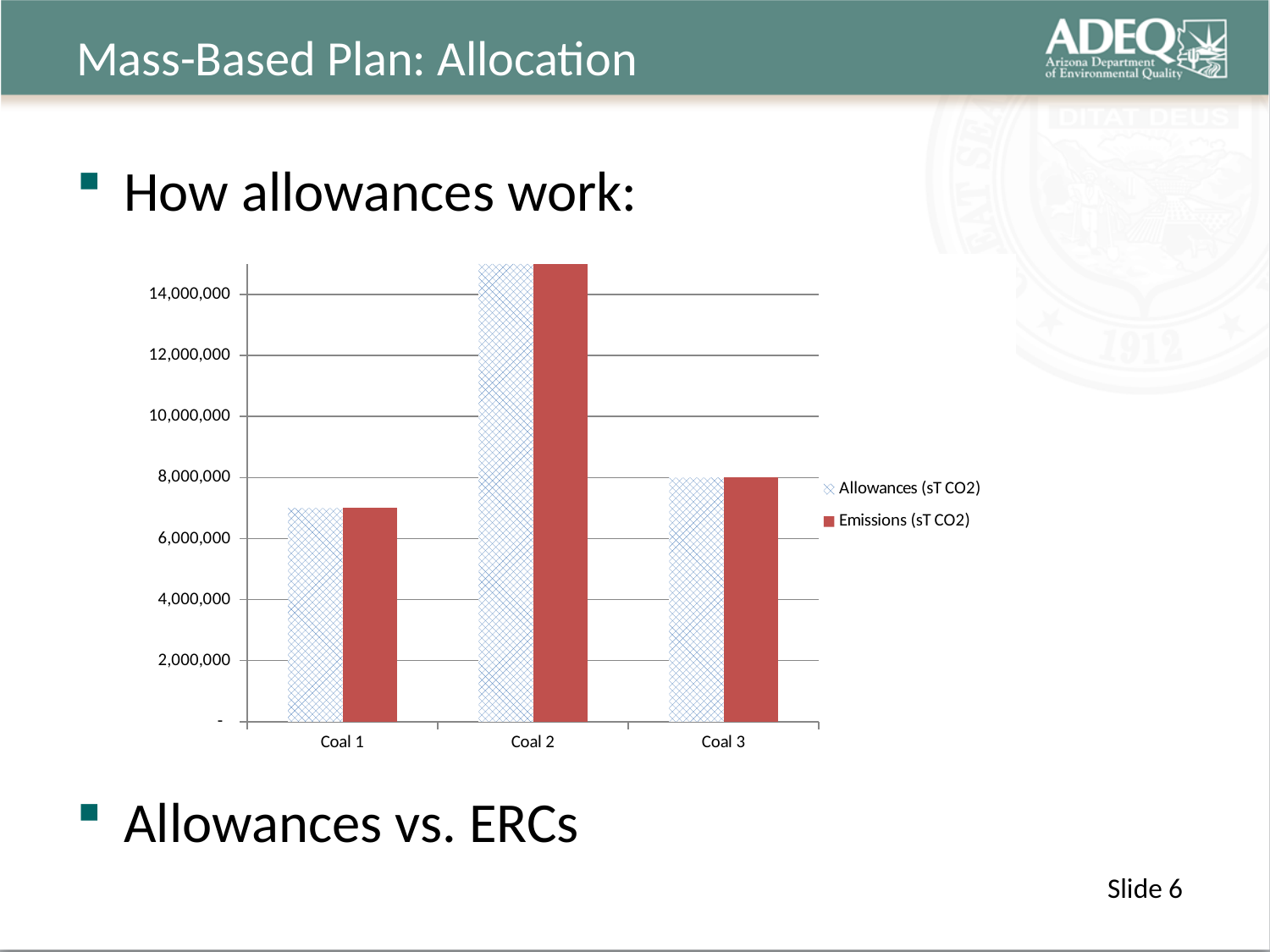
How many categories are shown on the x axis of the chart? 3 What colour are the Emissions (sT CO2) bars? red What is the Emissions (sT CO2) value for Coal 3? 8,000,000 Is the Emissions (sT CO2) value for Coal 2 greater or less than 14,000,000? greater What is the Allowances (sT CO2) value for Coal 3? 8,000,000 How many series does the chart's legend list? 2 Which category has the lowest Allowances (sT CO2) value? Coal 1 Which has a larger Emissions (sT CO2) value, Coal 2 or Coal 3? Coal 2 Which category has the highest Emissions (sT CO2) value? Coal 2 Is the Allowances (sT CO2) value for Coal 1 greater or less than 8,000,000? less Is the Allowances (sT CO2) value for Coal 1 greater or less than 6,000,000? greater What kind of chart is shown on the slide? bar chart